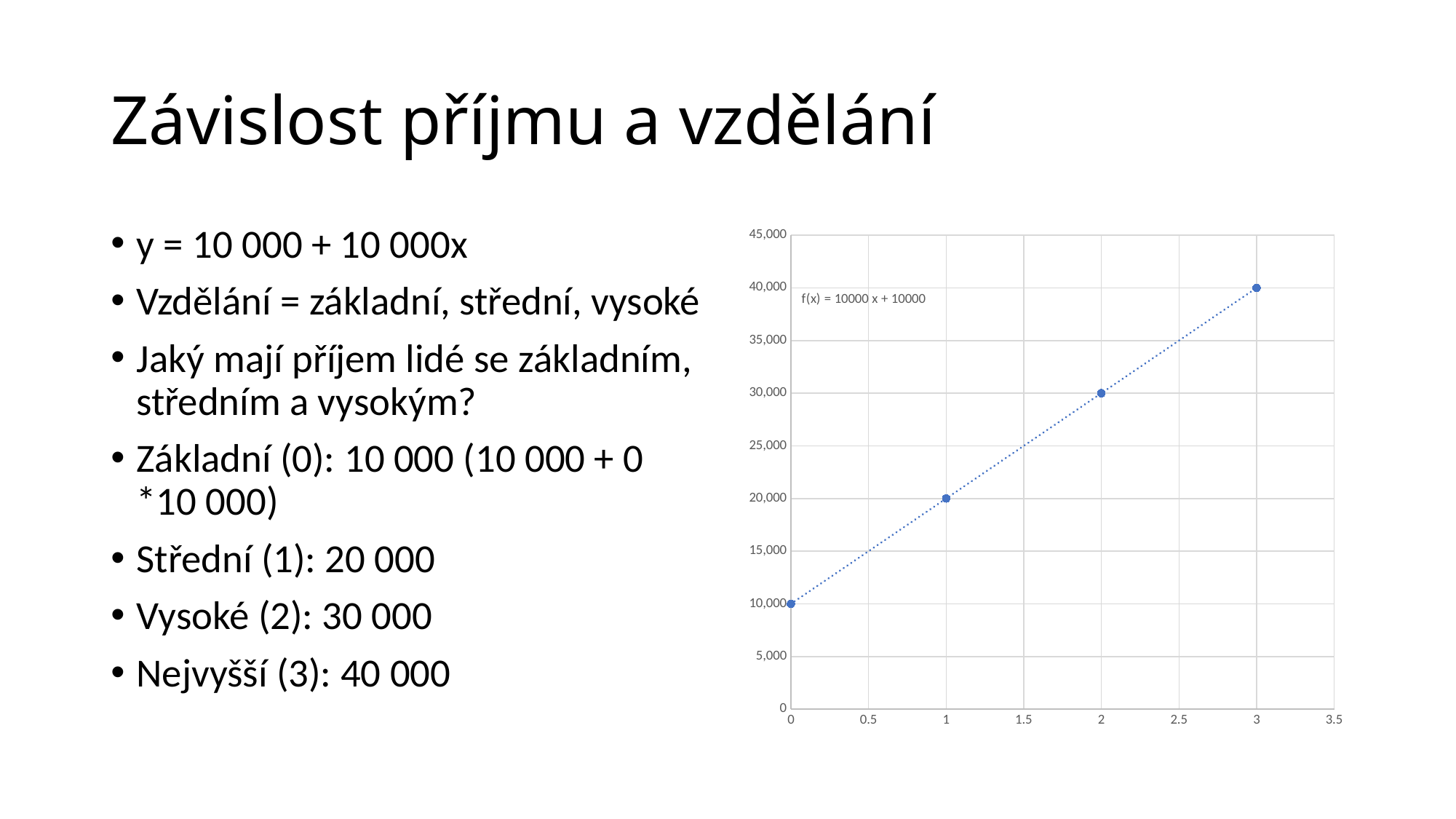
What kind of chart is shown on the slide? scatter chart Which has a larger y value, the point at x = 2 or the point at x = 1? x = 2 What is the y value of the point at x = 0? 10,000 What is the difference between the y values at x = 3 and x = 1? 20,000 Do the y values rise or fall as x increases along the x axis? rise What is the y value of the point at x = 1? 20,000 Which x value has the lowest y value on the chart? 0 Which x value has the highest y value on the chart? 3 What trendline equation is displayed on the chart? f(x) = 10000 x + 10000 What is the y value of the point at x = 2? 30,000 What is the y value of the point at x = 3? 40,000 How many data points are plotted on the chart? 4